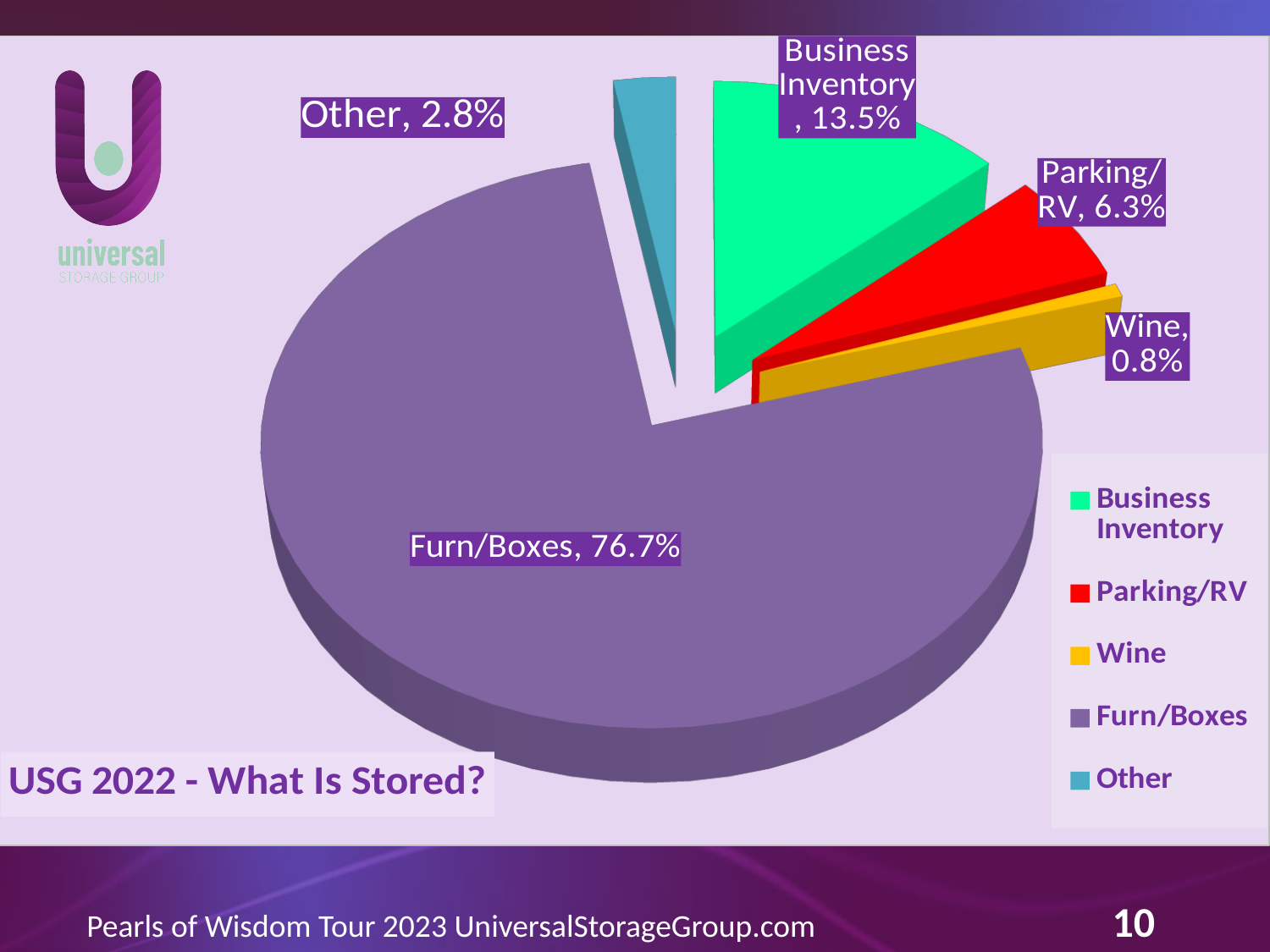
What share of the pie is Parking/RV? 6.3% Which category has the smallest slice of the pie? Wine Which category has the largest slice of the pie? Furn/Boxes What share of the pie is Business Inventory? 13.5% Which is larger, Other or Parking/RV? Parking/RV What share of the pie is Other? 2.8% How many categories does the pie chart show? 5 What is the title of the chart? USG 2022 - What Is Stored? What share of the pie is Wine? 0.8% What is the difference in percentage points between Business Inventory and Parking/RV? 7.2 What share of the pie is Furn/Boxes? 76.7% What kind of chart is shown on the slide? Pie chart